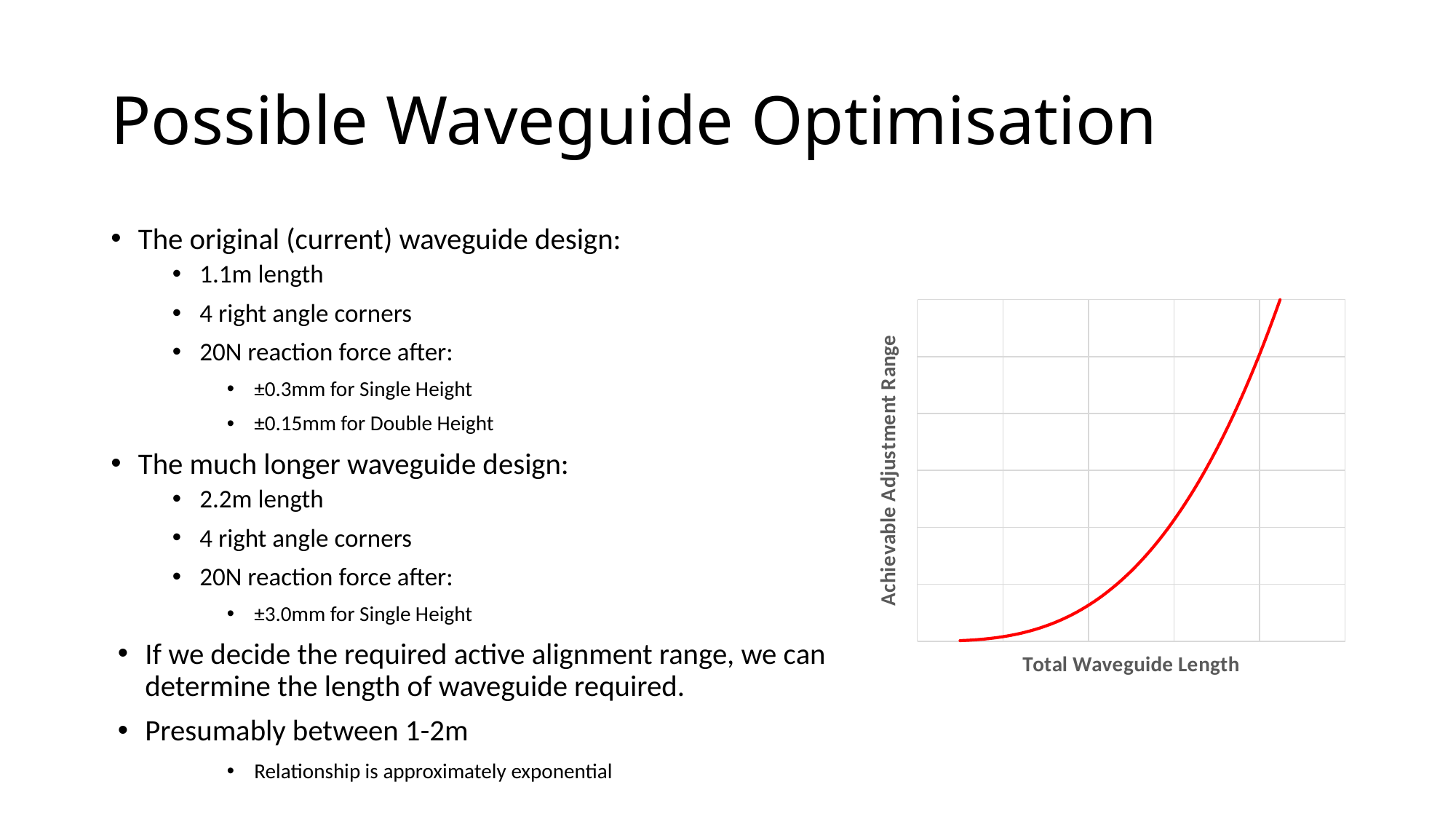
What is the label of the horizontal axis of the chart? Total Waveguide Length What kind of chart is shown on the slide? line chart Does the plotted line rise or fall as Total Waveguide Length increases? rise What is the label of the vertical axis of the chart? Achievable Adjustment Range How many lines are plotted on the chart? 1